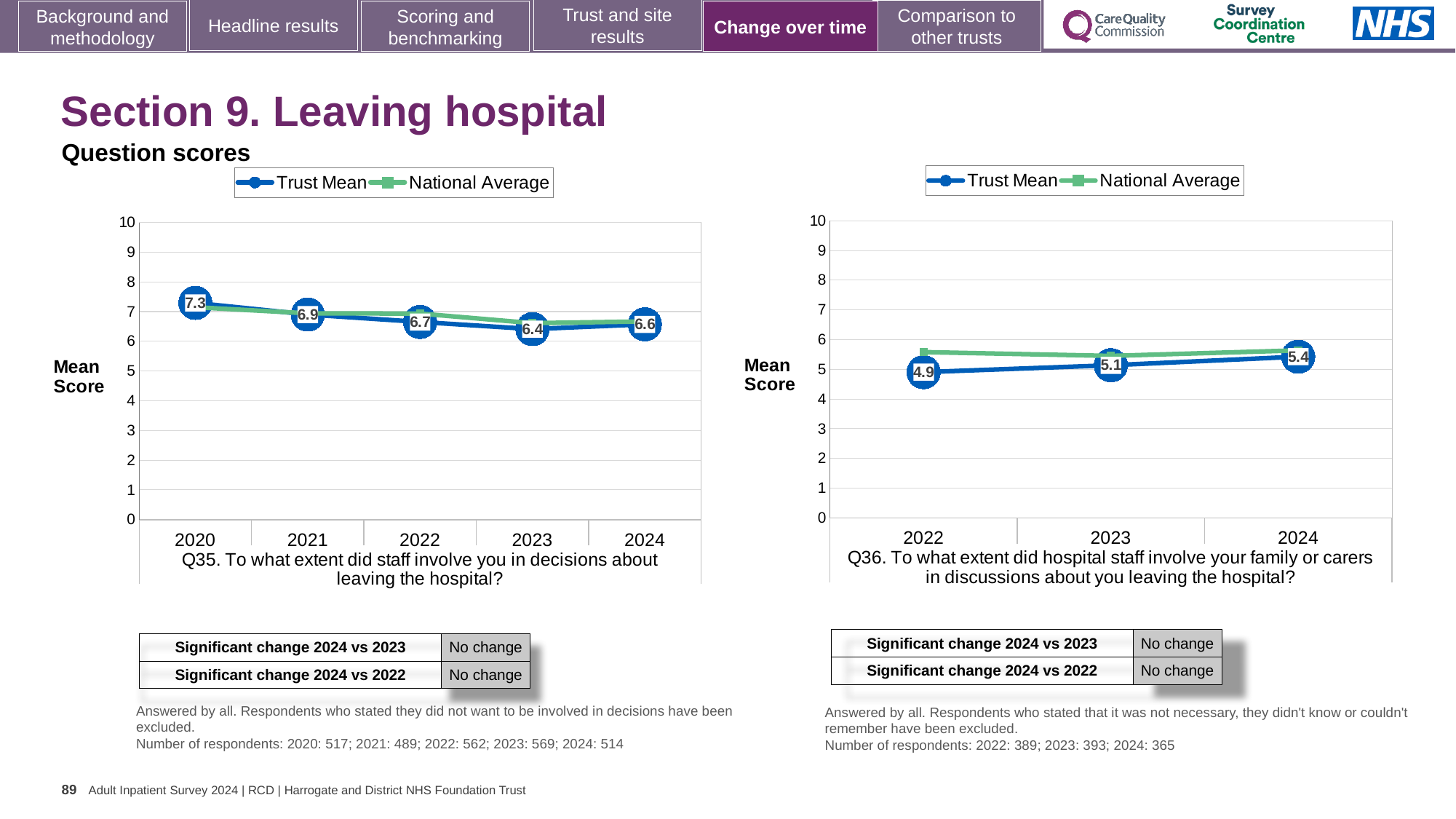
On the Q35 chart (left), what is the Trust Mean score for 2023? 6.4 On the Q36 chart (right), what is the Trust Mean score for 2024? 5.4 On the Q36 chart (right), what is the difference between the Trust Mean scores for 2024 and 2022? 0.5 On the Q35 chart (left), how many series does the legend list? 2 On the Q36 chart (right), how many years are shown on the x axis? 3 On the Q36 chart (right), what is the Trust Mean score for 2022? 4.9 On the Q35 chart (left), which year has the lowest Trust Mean score? 2023 What type of chart is used for Q35 (left)? Line chart On the Q35 chart (left), what is the difference between the Trust Mean scores for 2020 and 2024? 0.7 On the Q36 chart (right), is the Trust Mean score for 2022 higher or lower than for 2024? lower On the Q35 chart (left), what is the Trust Mean score for 2020? 7.3 On the Q35 chart (left), which year has the highest Trust Mean score? 2020